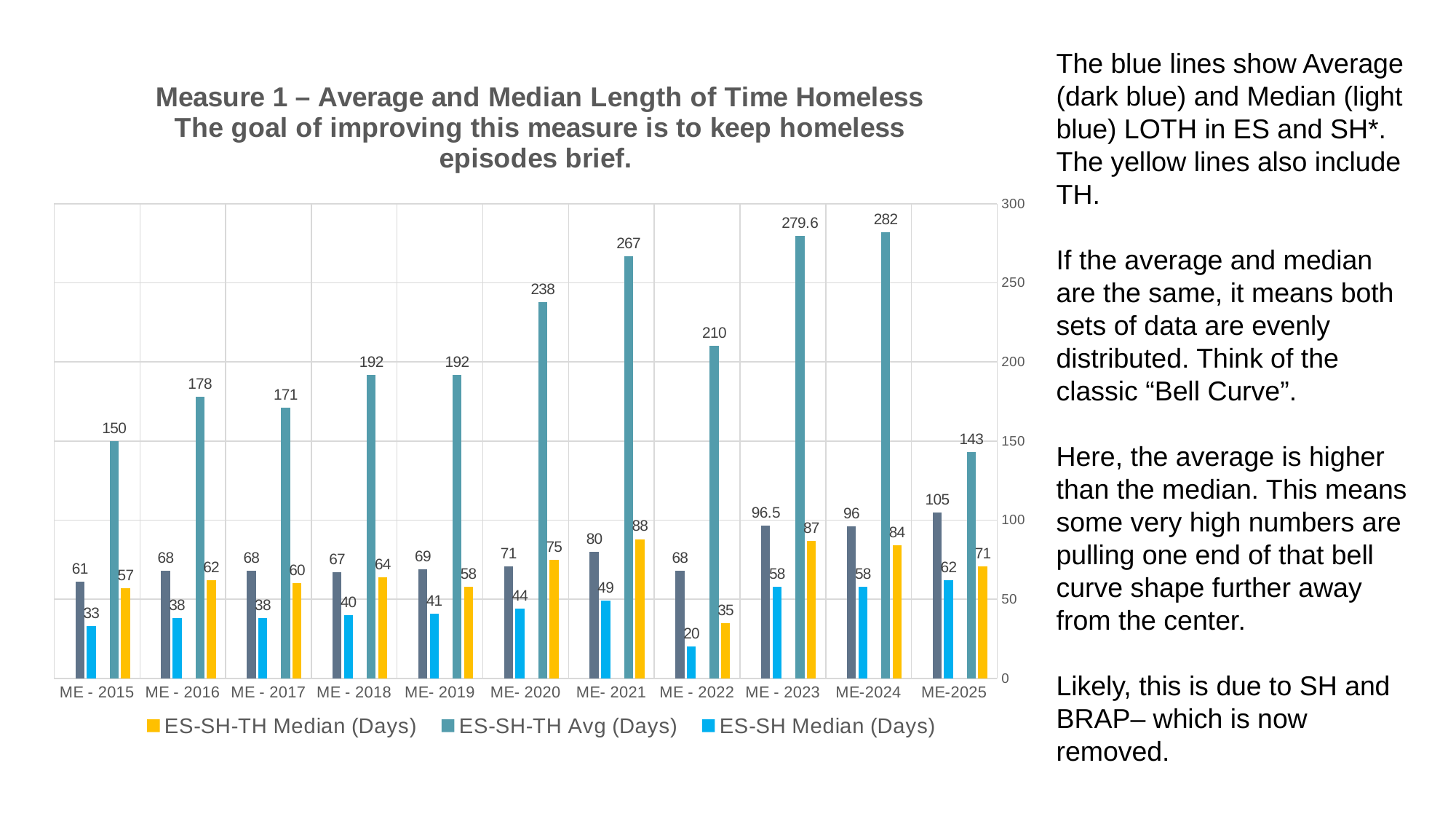
Which category has the lowest ES-SH Median (Days) value? ME - 2022 How many categories are shown on the x axis? 11 Is the ES-SH-TH Avg (Days) value for ME- 2020 greater or less than 200? greater What kind of chart is shown on the slide? bar chart Which is larger, the ES-SH-TH Median (Days) value for ME- 2020 or for ME - 2022? ME- 2020 Which category has the highest ES-SH-TH Avg (Days) value? ME-2024 How many series does the legend list? 3 What is the ES-SH-TH Median (Days) value for ME - 2018? 64 What is the ES-SH-TH Avg (Days) value for ME- 2021? 267 Does the ES-SH-TH Avg (Days) value rise or fall from ME - 2018 to ME- 2021? rise What is the difference between the ES-SH-TH Avg (Days) values for ME-2024 and ME-2025? 139 What is the ES-SH Median (Days) value for ME-2025? 62